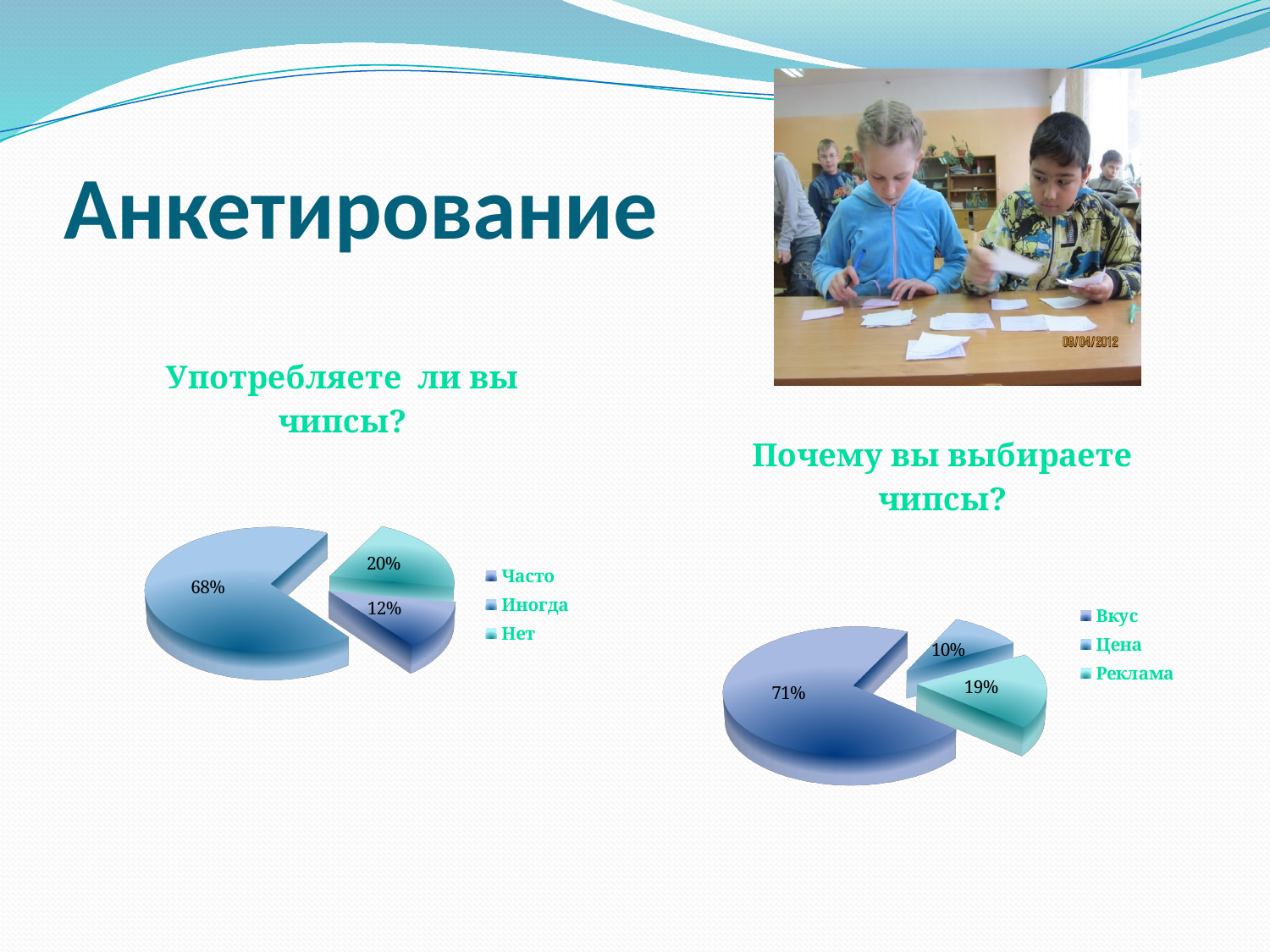
What type of chart is used for 'Употребляете ли вы чипсы?'? Pie chart In the chart 'Почему вы выбираете чипсы?', which category has the smallest slice? Цена In the chart 'Почему вы выбираете чипсы?', which is larger, 'Цена' or 'Реклама'? Реклама In the chart 'Употребляете ли вы чипсы?', what percentage is shown for 'Нет'? 20% In the chart 'Почему вы выбираете чипсы?', what is the difference between the 'Вкус' and 'Реклама' slices? 52% In the chart 'Почему вы выбираете чипсы?', what percentage is shown for 'Реклама'? 19% In the chart 'Употребляете ли вы чипсы?', what percentage is shown for 'Часто'? 12% In the chart 'Почему вы выбираете чипсы?', what percentage is shown for 'Вкус'? 71% In the chart 'Употребляете ли вы чипсы?', which category has the smallest slice? Часто In the chart 'Употребляете ли вы чипсы?', what is the difference between the 'Нет' and 'Иногда' slices? 48% How many categories does the legend of the chart 'Почему вы выбираете чипсы?' list? 3 In the chart 'Употребляете ли вы чипсы?', which category has the largest slice? Иногда